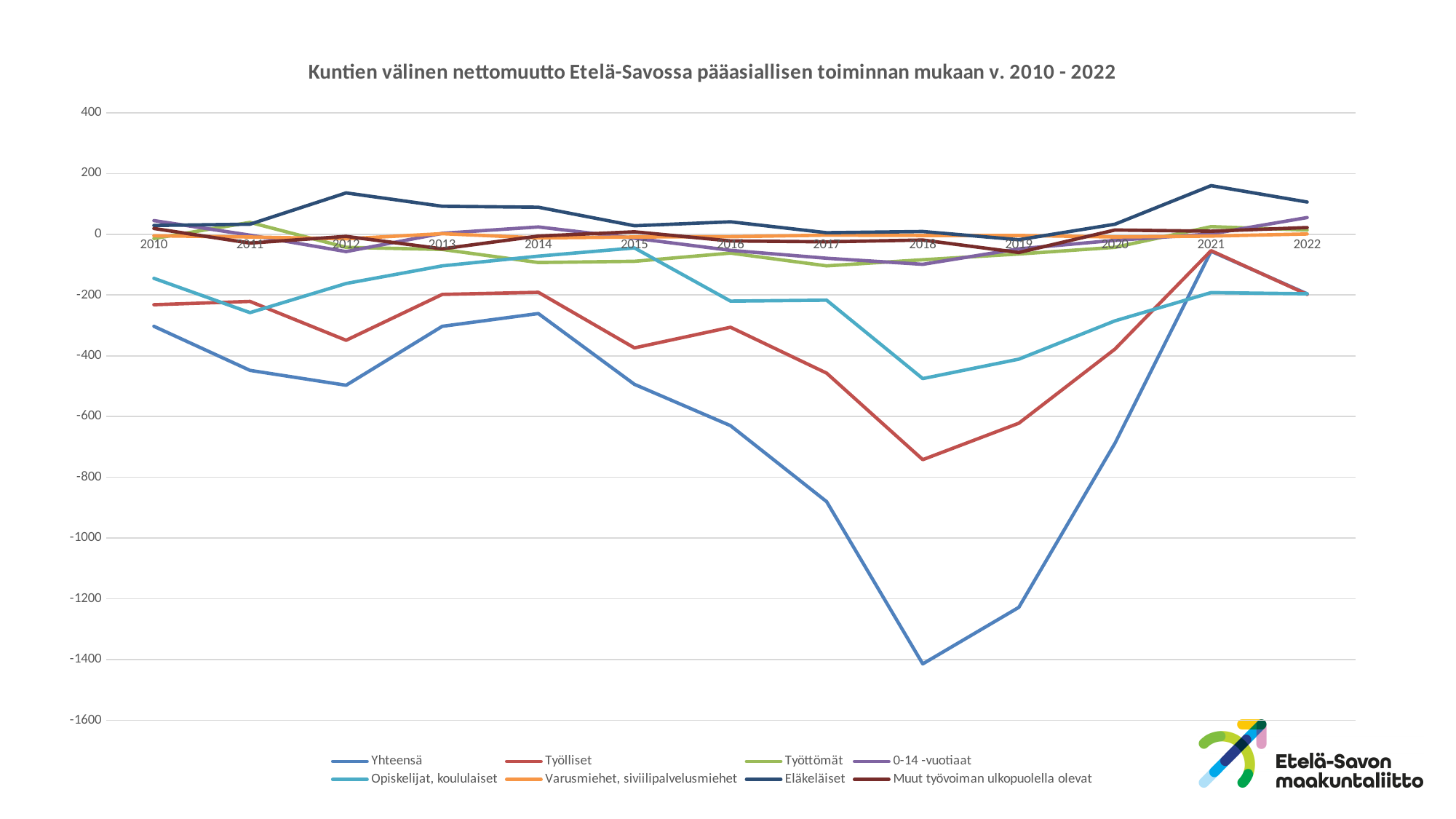
Is the value for Eläkeläiset in 2021 greater or less than 100? greater Which is larger in 2018, the value for Yhteensä or the value for Työlliset? Työlliset Is the value for Työlliset in 2018 greater or less than -600? less How many years are plotted along the x axis? 13 In which year does the Yhteensä series reach its lowest value? 2018 Is the value for Opiskelijat, koululaiset in 2018 greater or less than -400? less What is the title of the chart? Kuntien välinen nettomuutto Etelä-Savossa pääasiallisen toiminnan mukaan v. 2010 - 2022 How many series does the legend list? 8 What kind of chart is shown on the slide? line chart In which year does the Eläkeläiset series reach its highest value? 2021 Does the Yhteensä series rise or fall from 2018 to 2021? rise